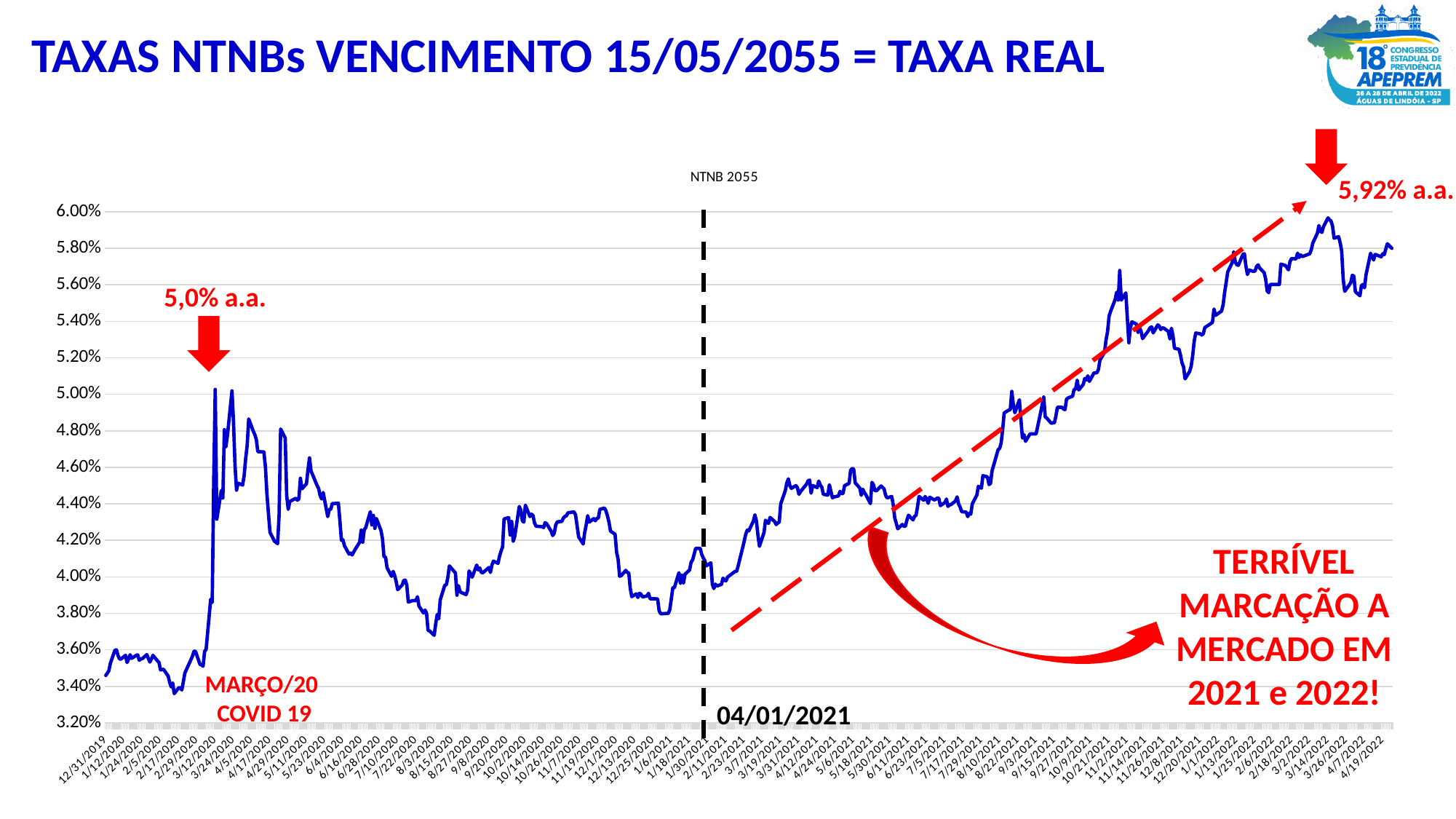
Is the value at 8/3/2020 greater or less than 4.00%? less What rate is annotated at the 2022 peak of the line? 5,92% a.a. What is the title printed above the chart? NTNB 2055 Does the line generally rise or fall from 04/01/2021 to the end of the series? rise Which annotated peak is higher: the March 2020 peak or the 2022 peak? the 2022 peak What type of chart is shown on the slide? line chart What date is marked by the dashed vertical line on the chart? 04/01/2021 In which year does the line reach its highest value? 2022 Is the value at 4/19/2022 greater or less than 5.60%? greater What rate is annotated at the March 2020 peak of the line? 5,0% a.a. Is the value at 12/31/2019 greater or less than 3.60%? less Is the value at 4/19/2022 larger or smaller than the value at 12/31/2019? larger